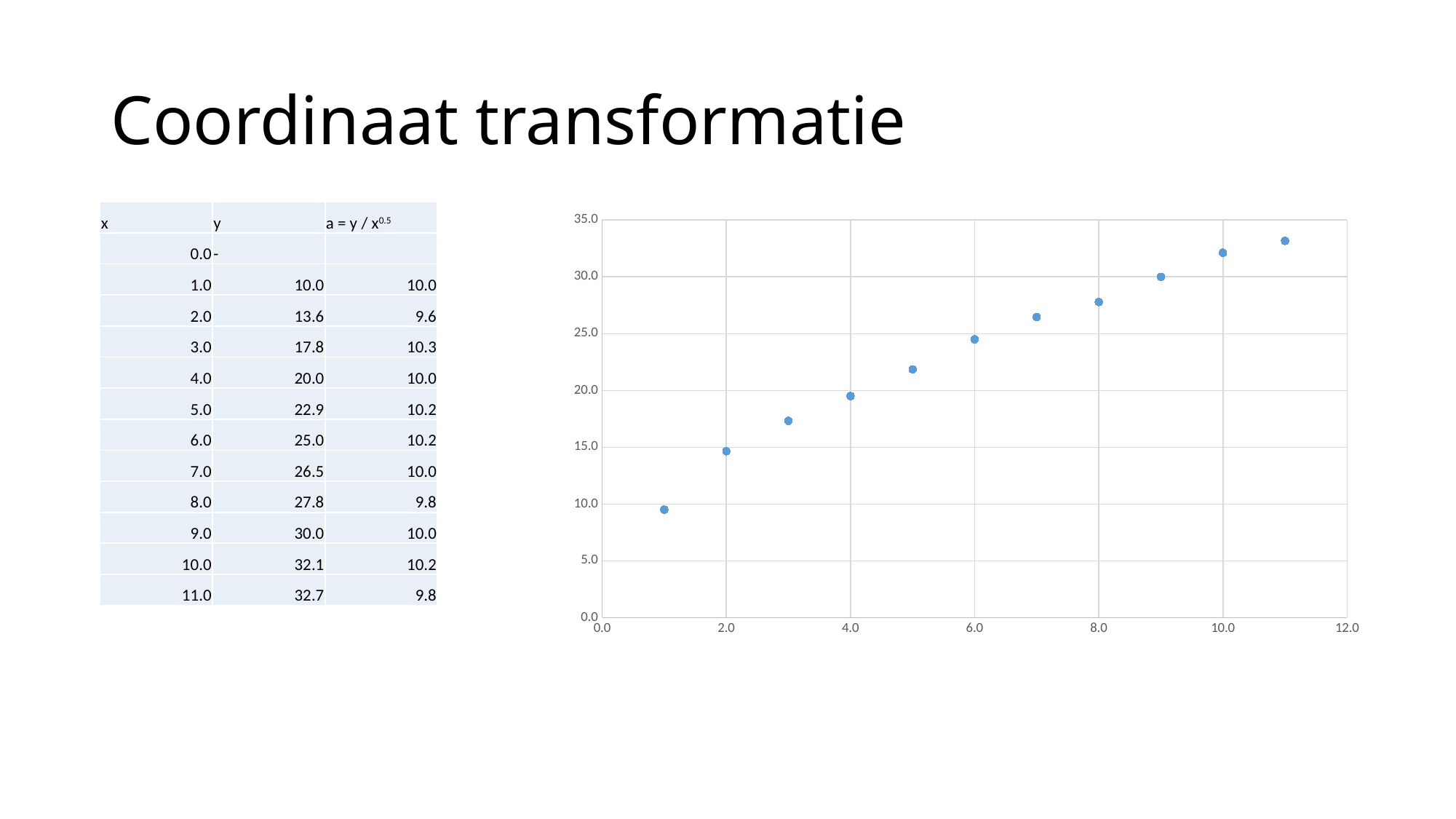
What kind of chart is shown on the slide? scatter chart Which has the larger plotted value, the point at x = 5.0 or the point at x = 7.0? x = 7.0 Do the plotted values rise or fall as x increases along the x axis? rise Is the plotted value at x = 8.0 greater or less than 25.0? greater Is the plotted value at x = 11.0 greater or less than 30.0? greater Is the plotted value at x = 1.0 greater or less than 10.0? less What is the highest tick value shown on the chart's y axis? 35.0 At which x value is the highest point plotted? 11.0 How many data points are plotted in the chart? 11 At which x value is the lowest point plotted? 1.0